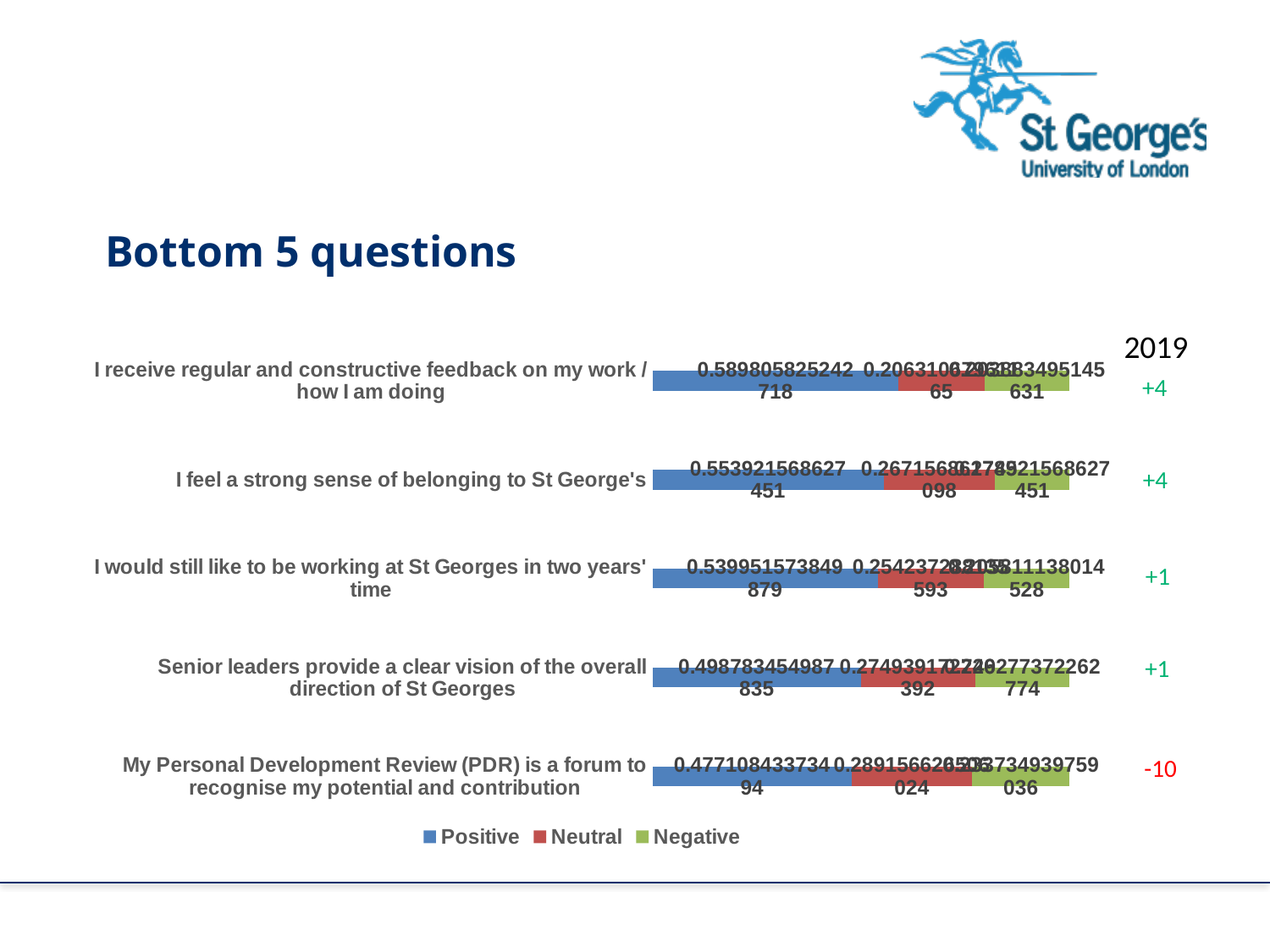
What kind of chart is shown on the slide? Stacked bar chart Which question has the largest Positive share? I receive regular and constructive feedback on my work / how I am doing Which question shows a negative 2019 change? My Personal Development Review (PDR) is a forum to recognise my potential and contribution What 2019 change is shown next to 'My Personal Development Review (PDR) is a forum to recognise my potential and contribution'? -10 How many questions (categories) are plotted in the chart? 5 Is the Positive share larger for 'I receive regular and constructive feedback on my work / how I am doing' or for 'My Personal Development Review (PDR) is a forum to recognise my potential and contribution'? I receive regular and constructive feedback on my work / how I am doing Going down the chart from the top question to the bottom question, does the Positive share rise or fall? Fall What 2019 change is shown next to 'I feel a strong sense of belonging to St George's'? +4 What is the title of the slide containing the chart? Bottom 5 questions What are the three series named in the legend? Positive, Neutral, Negative How many series does the chart legend list? 3 Which question has the smallest Positive share? My Personal Development Review (PDR) is a forum to recognise my potential and contribution